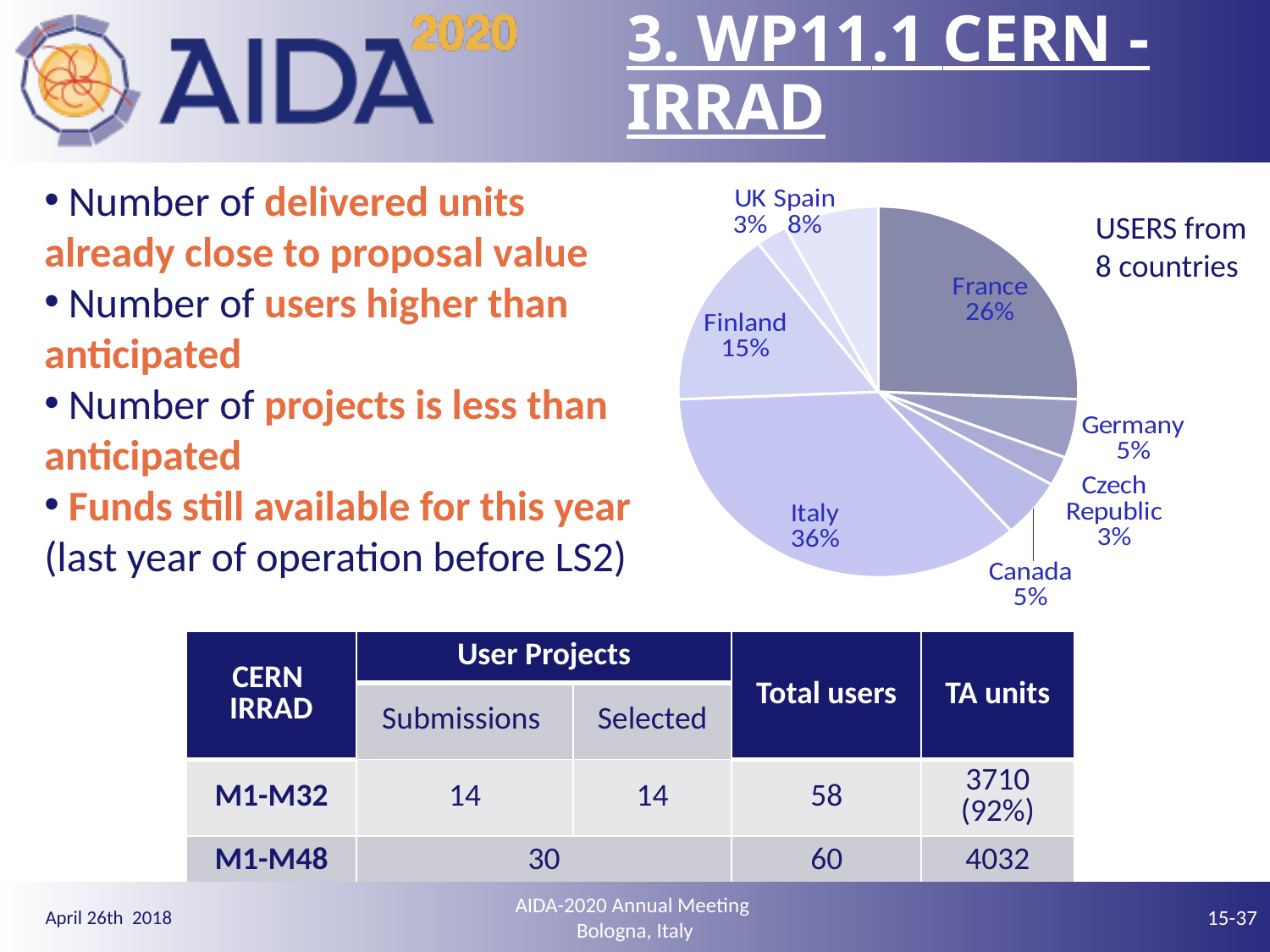
What is the difference in percentage points between Italy and France in the pie chart? 10 What share of users does France account for in the pie chart? 26% What is the value shown for Germany in the pie chart? 5% What is the difference in percentage points between Finland and Spain in the pie chart? 7 Which slice is larger in the pie chart, Finland or Spain? Finland How many countries are shown as slices in the pie chart? 8 What is the value shown for Spain in the pie chart? 8% What kind of chart is shown on the slide? pie chart Which country has the largest slice in the pie chart? Italy According to the text next to the pie chart, users come from how many countries? 8 countries What share of users does Italy account for in the pie chart? 36% What is the value shown for Finland in the pie chart? 15%